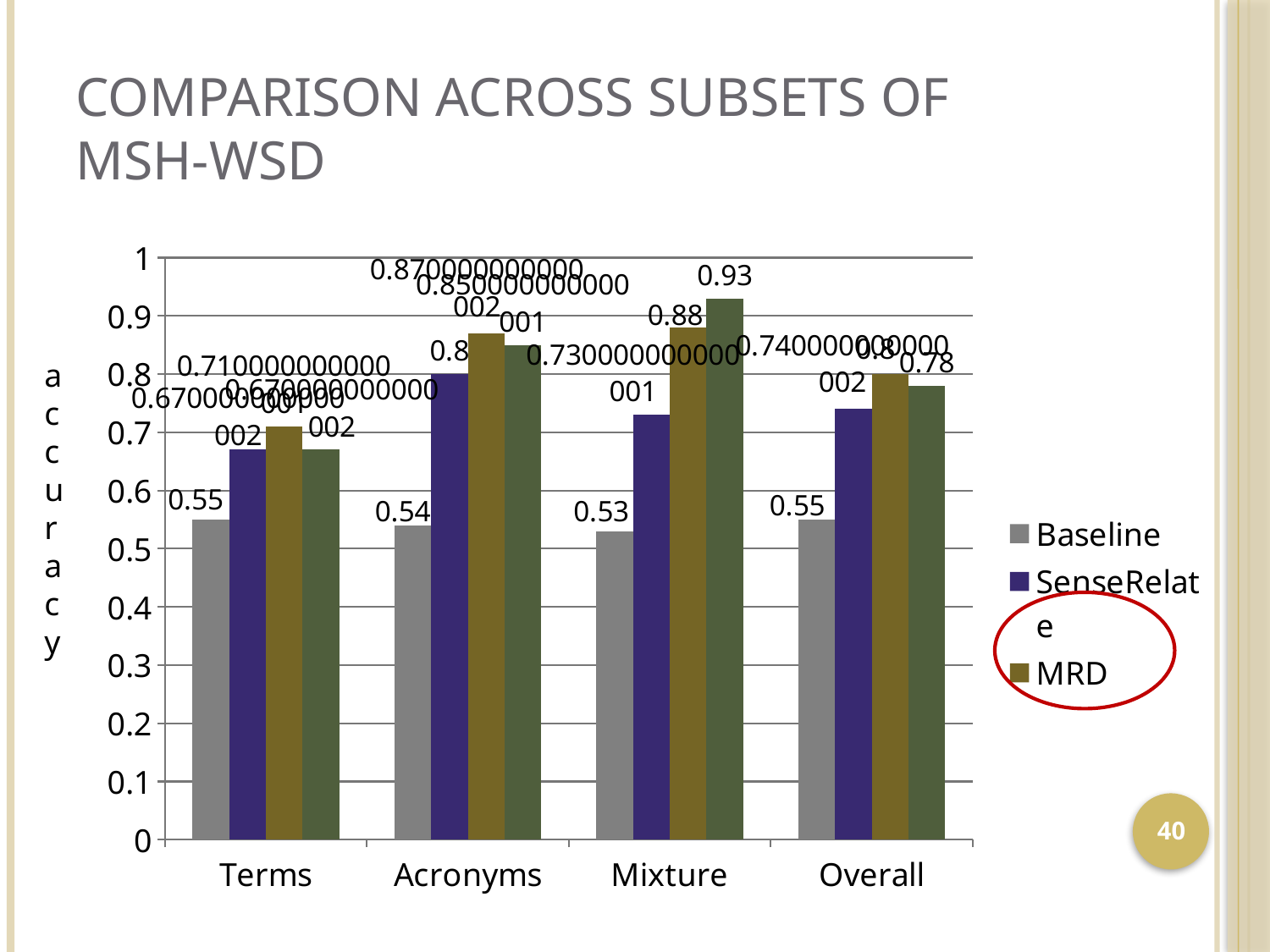
What is the difference between the MRD and Baseline accuracy for Mixture? 0.35 What is the Baseline accuracy for Mixture? 0.53 What kind of chart is shown on the slide? bar chart What is the Baseline accuracy for Acronyms? 0.54 How many categories are shown on the x axis? 4 What is the SenseRelate accuracy for Acronyms? 0.8 For which category is the MRD accuracy highest? Mixture What is the MRD accuracy for Mixture? 0.88 What is the Baseline accuracy for Terms? 0.55 What is the MRD accuracy for Overall? 0.8 Is the SenseRelate accuracy for Overall greater or less than 0.7? greater For which category is the Baseline accuracy lowest? Mixture